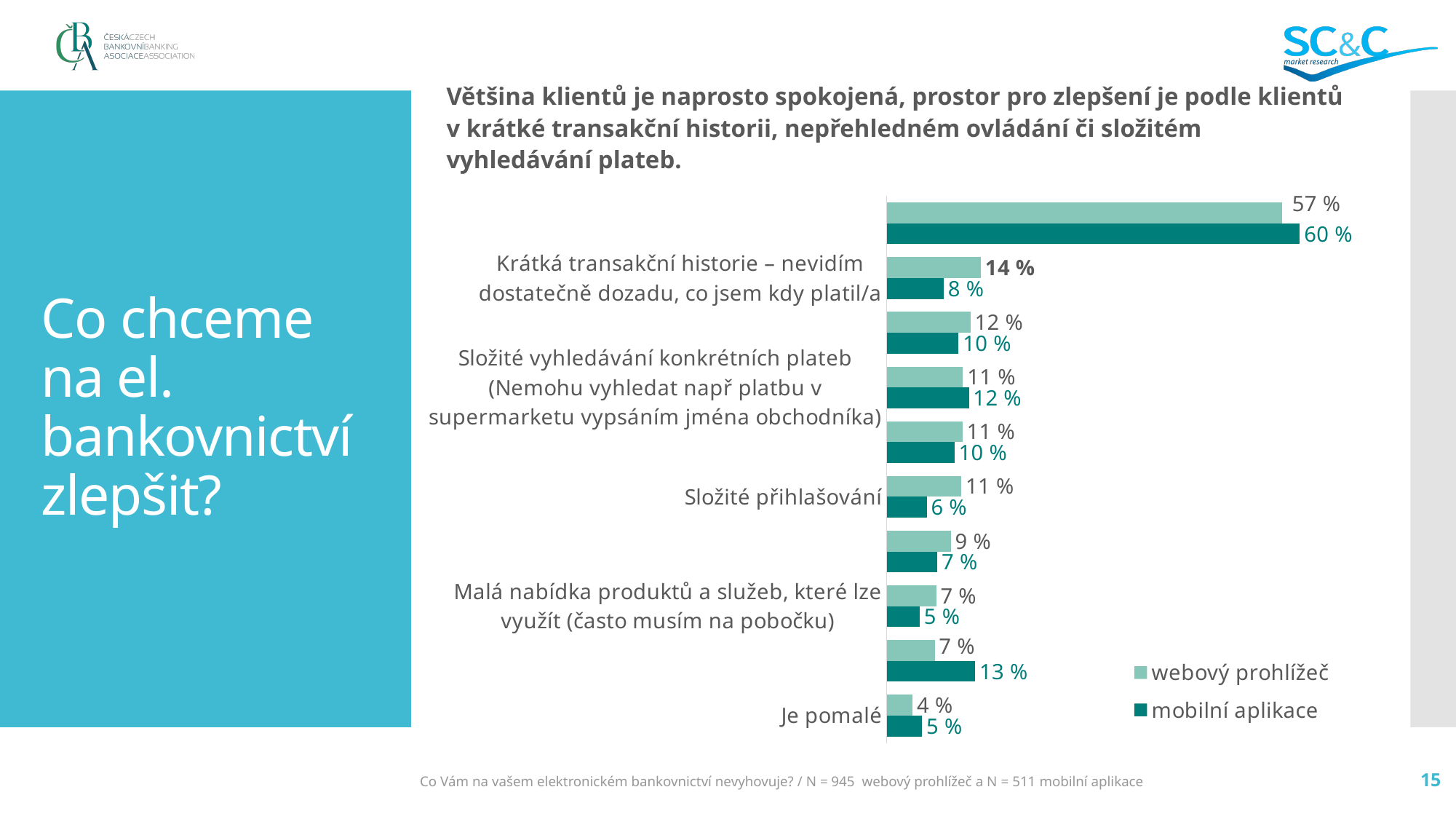
What is the value for 'webový prohlížeč' for 'Krátká transakční historie – nevidím dostatečně dozadu, co jsem kdy platil/a'? 14 % What is the value for 'webový prohlížeč' for 'Je pomalé'? 4 % What is the value for 'mobilní aplikace' for 'Složité přihlašování'? 6 % What is the value for 'mobilní aplikace' for 'Malá nabídka produktů a služeb, které lze využít (často musím na pobočku)'? 5 % What kind of chart is shown on the slide? bar chart What is the difference between the 'webový prohlížeč' and 'mobilní aplikace' values for 'Složité přihlašování'? 5 % What is the value of the 'mobilní aplikace' bar in the topmost pair of bars on the chart? 60 % What is the value for 'mobilní aplikace' for 'Krátká transakční historie – nevidím dostatečně dozadu, co jsem kdy platil/a'? 8 % What are the two series named in the chart legend? webový prohlížeč, mobilní aplikace For 'Složité vyhledávání konkrétních plateb (Nemohu vyhledat např platbu v supermarketu vypsáním jména obchodníka)', which series has the larger value, 'webový prohlížeč' or 'mobilní aplikace'? mobilní aplikace How many pairs of bars (categories) are plotted on the chart? 10 How many series does the chart legend list? 2